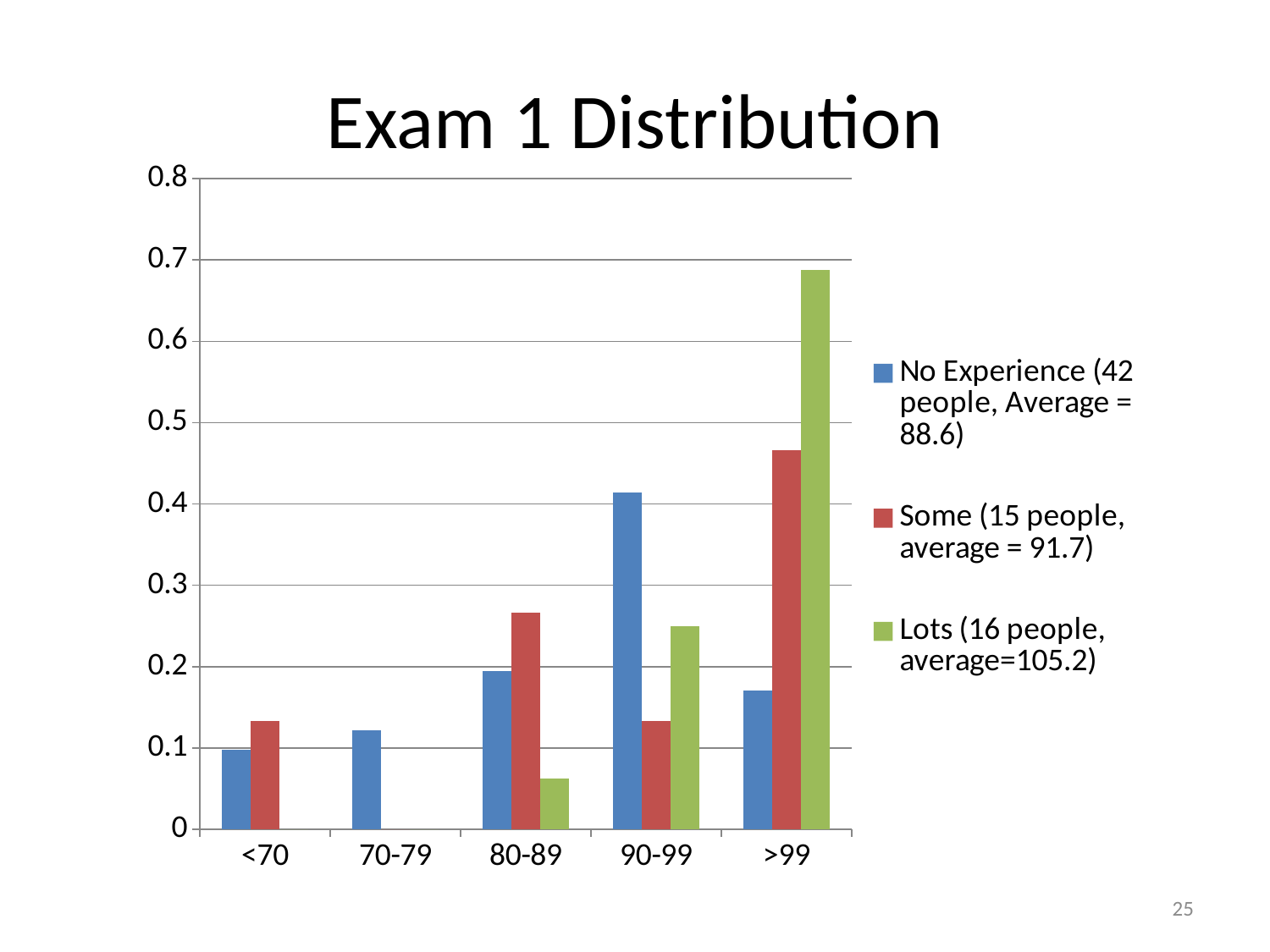
Is the value for the Lots series in the >99 category greater or less than 0.6? greater How many series does the legend list? 3 In which score category is the No Experience series highest? 90-99 In the 80-89 category, which series has the larger value: Some or No Experience? Some What kind of chart is shown on the slide? bar chart How many score categories are shown on the x axis? 5 Which colour represents the Lots (16 people, average=105.2) series? green Is the value for the Some series in the >99 category greater or less than 0.5? less Is the value for the No Experience series in the 90-99 category greater or less than 0.3? greater In the >99 category, which series has the larger value: Some or No Experience? Some In which score category is the Lots series highest? >99 What is the title of the chart? Exam 1 Distribution